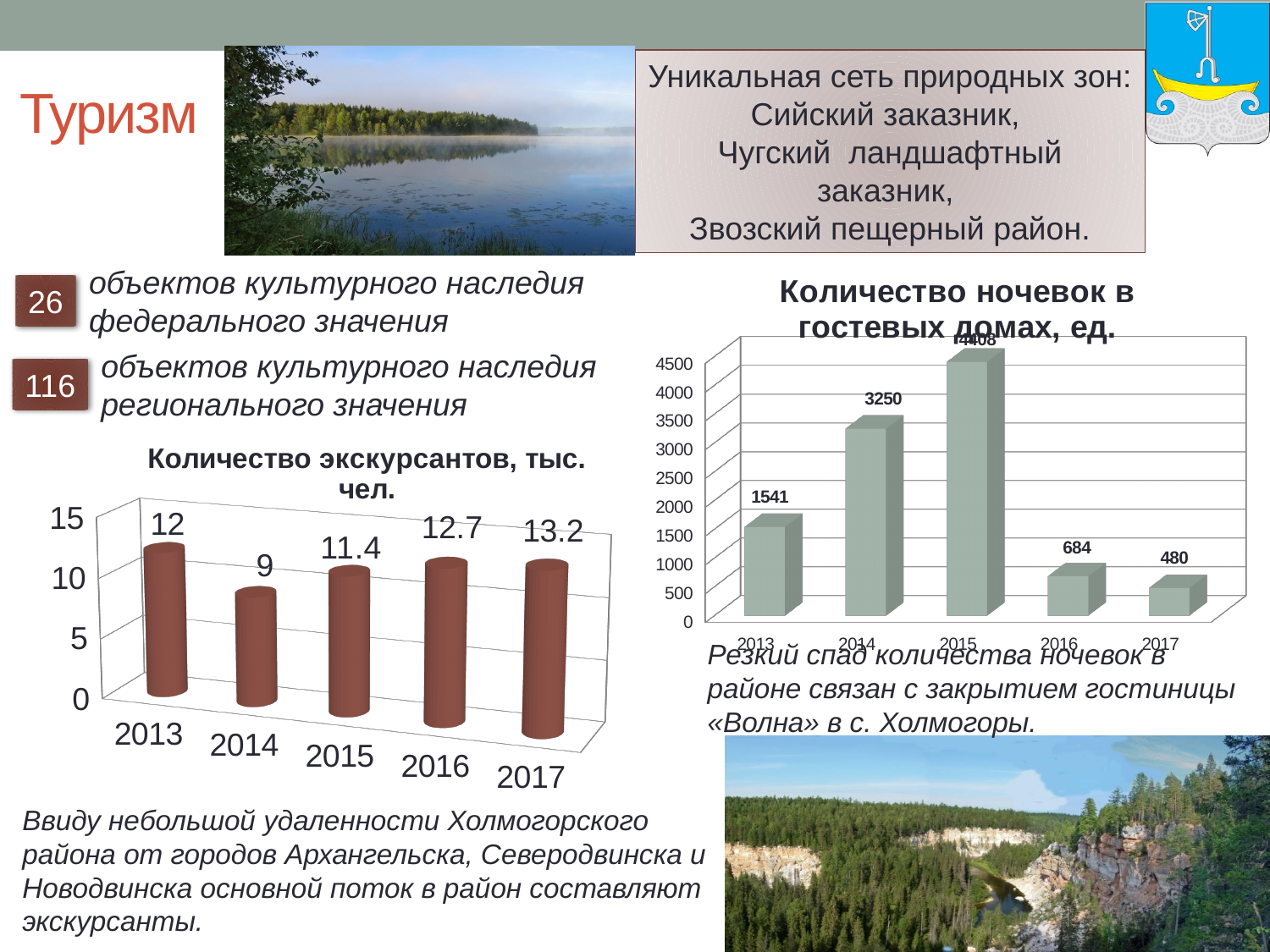
In the chart 'Количество экскурсантов, тыс. чел.', what is the difference between the values for 2017 and 2013? 1.2 In the chart 'Количество ночевок в гостевых домах, ед.', which year has the highest value? 2015 In the chart 'Количество экскурсантов, тыс. чел.', how many years are shown on the x axis? 5 What kind of chart is 'Количество ночевок в гостевых домах, ед.'? Bar chart In the chart 'Количество ночевок в гостевых домах, ед.', what is the value for 2016? 684 In the chart 'Количество экскурсантов, тыс. чел.', which year has the lowest value? 2014 In the chart 'Количество ночевок в гостевых домах, ед.', what is the difference between the values for 2014 and 2013? 1709 In the chart 'Количество ночевок в гостевых домах, ед.', what is the value for 2013? 1541 In the chart 'Количество экскурсантов, тыс. чел.', what is the value for 2017? 13.2 In the chart 'Количество ночевок в гостевых домах, ед.', which year has the lowest value? 2017 In the chart 'Количество экскурсантов, тыс. чел.', what is the value for 2014? 9 In the chart 'Количество экскурсантов, тыс. чел.', which year has the highest value? 2017